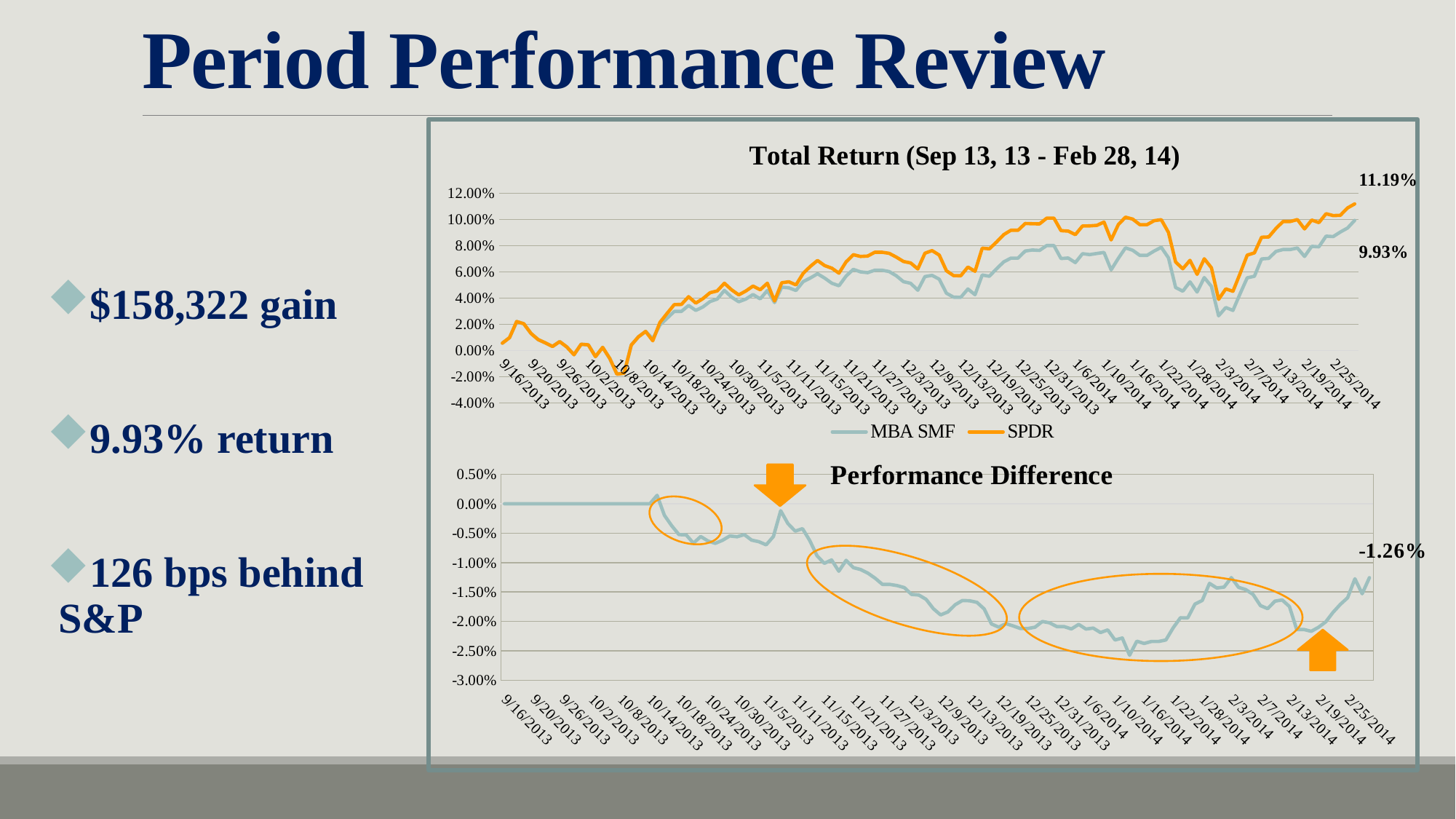
What is the title of the top chart on the slide? Total Return (Sep 13, 13 - Feb 28, 14) In the Total Return chart, what is the final value labelled for the MBA SMF series? 9.93% In the Total Return chart, is the SPDR value around 2/3/2014 greater or less than 6.00%? less In the Total Return chart, what is the difference between the final SPDR value and the final MBA SMF value? 1.26% In the Total Return chart, do the values generally rise or fall from September 2013 to February 2014? Rise In the Performance Difference chart, is the value around 1/10/2014 greater or less than -2.00%? less In the Total Return chart, what is the final value labelled for the SPDR series? 11.19% In the Total Return chart, which series ends higher, MBA SMF or SPDR? SPDR What kind of chart is the Total Return chart? Line chart How many series does the legend of the Total Return chart list? 2 In the Performance Difference chart, what is the final value labelled at the end of the line? -1.26% In the Total Return chart, which series is drawn in orange? SPDR